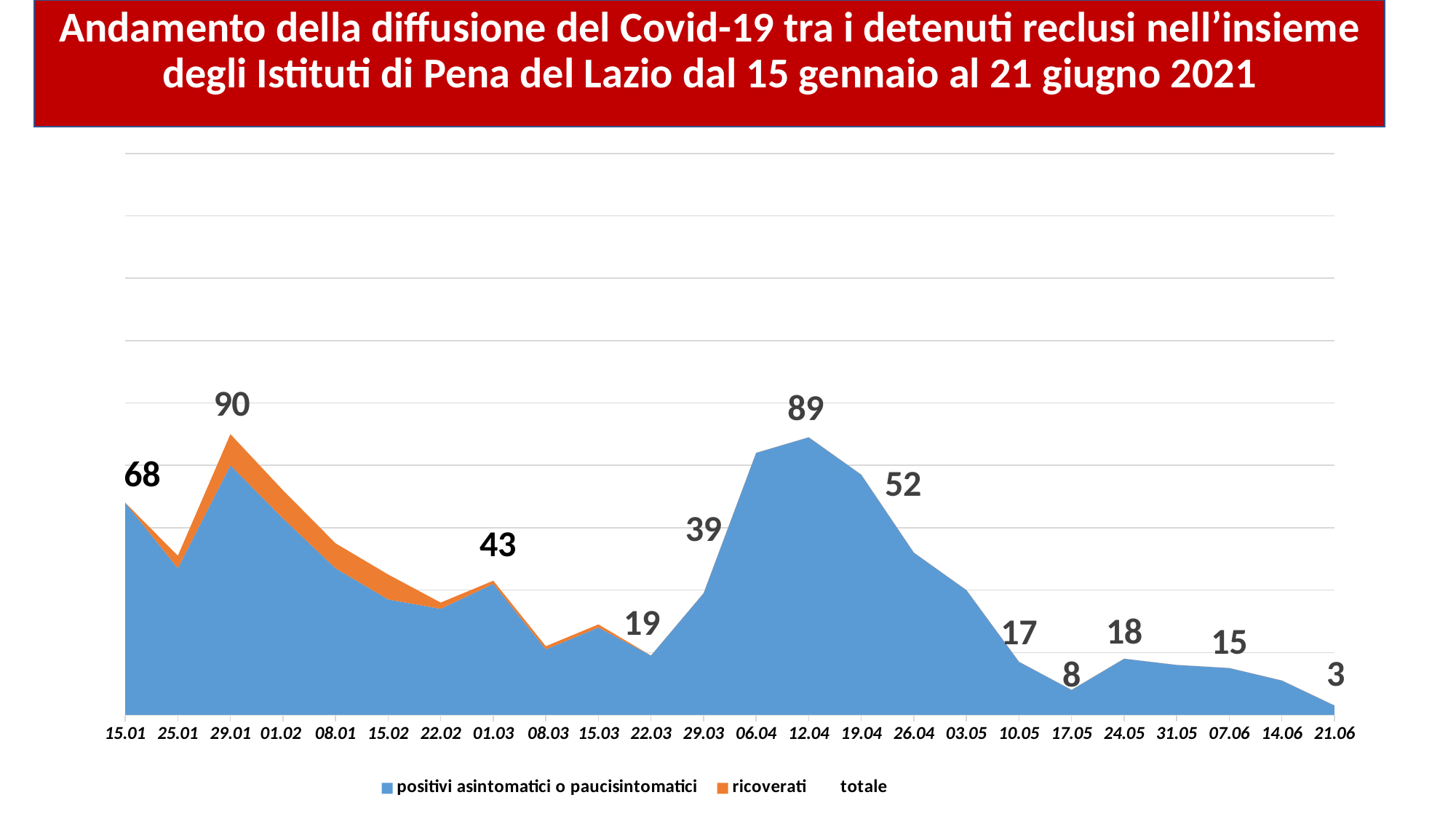
Which is larger, the labelled total for 01.03 or for 29.03? 01.03 How many series does the legend list? 3 What is the total value shown for 12.04? 89 Which date has the lowest labelled total? 21.06 What is the difference between the labelled totals for 29.01 and 12.04? 1 What kind of chart is shown on the slide? Area chart Which date has the highest labelled total? 29.01 Which series is shown in orange? ricoverati What is the total value shown for 29.01? 90 How many dates are shown on the x axis? 24 What is the total value shown for 15.01? 68 What is the total value shown for 21.06? 3